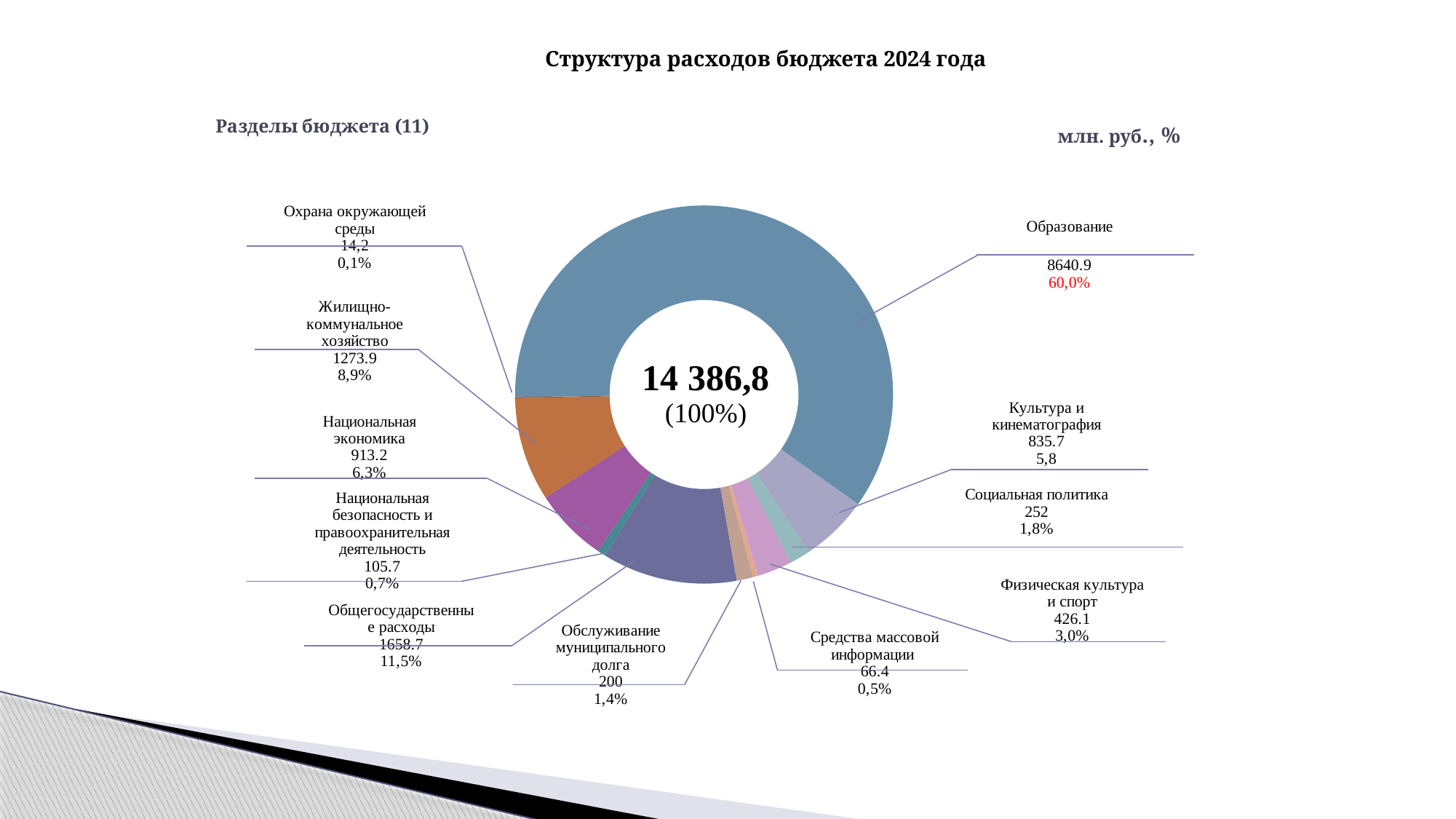
Which is larger, the value for Национальная экономика or the value for Культура и кинематография? Национальная экономика Which budget section has the largest share? Образование How many budget sections are shown in the chart? 11 What is the value shown for Образование? 8640.9 What percentage share is shown for Образование? 60,0% What is the value shown for Общегосударственные расходы? 1658.7 What is the total shown in the centre of the chart? 14 386,8 What is the difference between the values for Физическая культура и спорт and Социальная политика? 174.1 Which budget section has the smallest share? Охрана окружающей среды What percentage share is shown for Жилищно-коммунальное хозяйство? 8,9% What is the title of the chart? Разделы бюджета (11) What kind of chart is shown on the slide? Doughnut (pie) chart